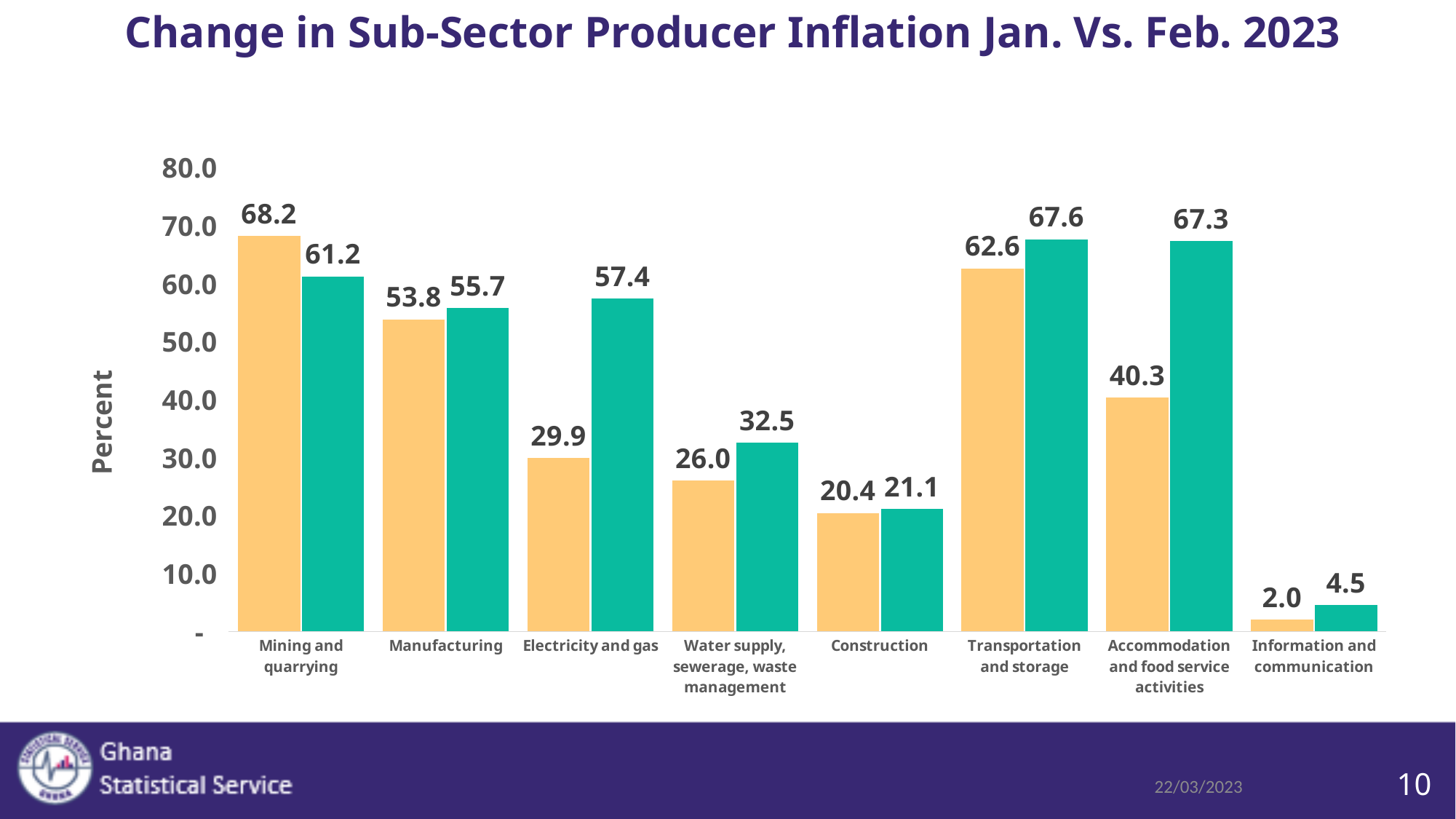
What is the label on the vertical axis? Percent What is the value of the yellow bar for Mining and quarrying? 68.2 Which sub-sector has the lowest yellow bar? Information and communication What is the value of the green bar for Electricity and gas? 57.4 What kind of chart is shown on the slide? bar chart How many sub-sectors are shown on the x axis? 8 What is the difference between the yellow and green bars for Mining and quarrying? 7.0 For Manufacturing, which is larger, the yellow bar or the green bar? the green bar Is the green bar for Water supply, sewerage, waste management greater or less than 30.0? greater Which sub-sector has the highest green bar? Transportation and storage What is the value of the yellow bar for Accommodation and food service activities? 40.3 What is the difference between the green and yellow bars for Accommodation and food service activities? 27.0